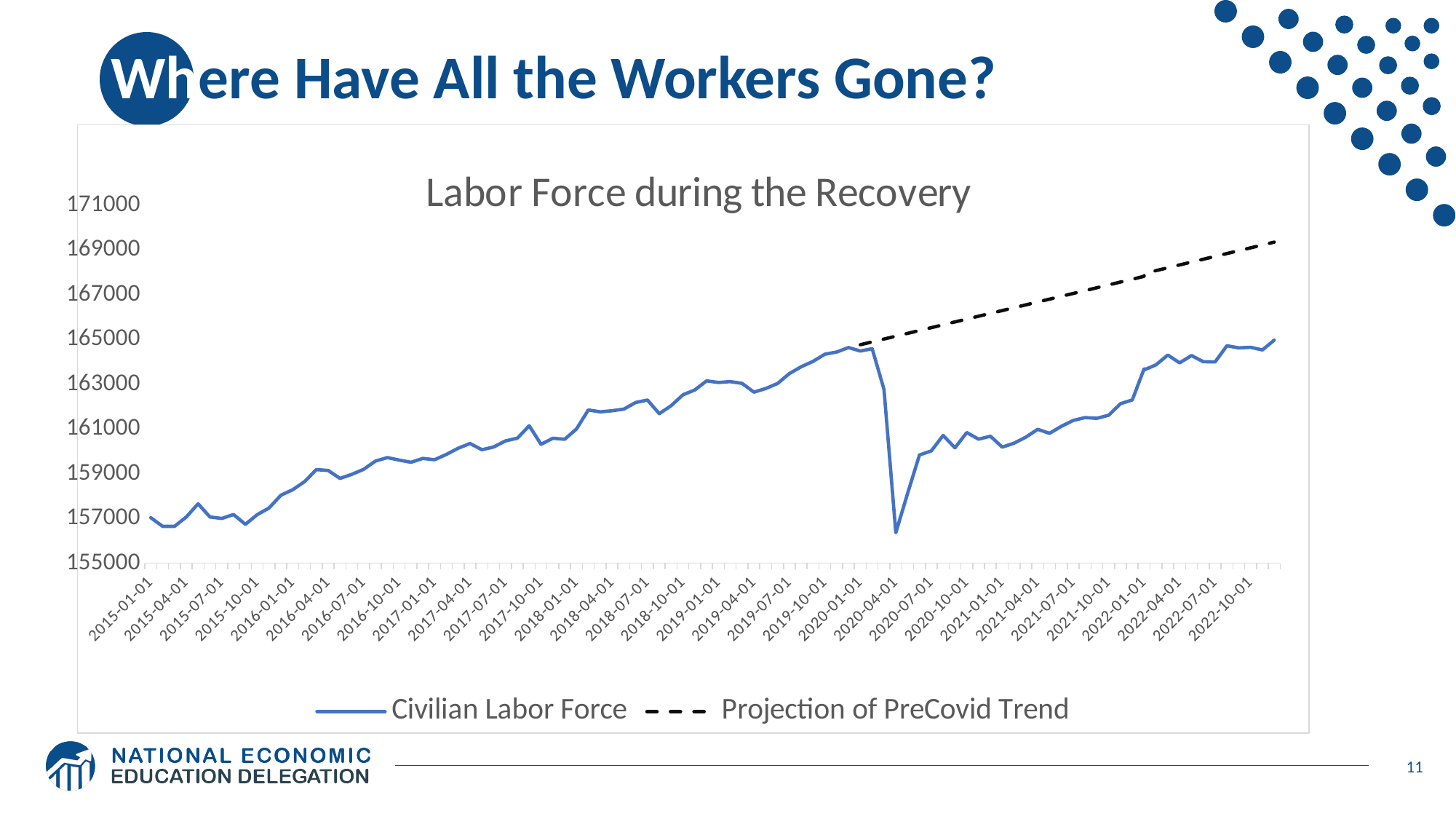
Is the Projection of PreCovid Trend value at 2022-10-01 greater or less than 167000? greater At 2022-10-01, which is higher: the Civilian Labor Force or the Projection of PreCovid Trend? Projection of PreCovid Trend What kind of chart is shown on the slide? line chart Is the Civilian Labor Force value at 2020-04-01 greater or less than 157000? less Which series is drawn as a dashed line? Projection of PreCovid Trend Is the Civilian Labor Force value at 2016-01-01 greater or less than 159000? less Does the Civilian Labor Force generally rise or fall from 2015-01-01 to 2020-01-01? rise At which date does the Civilian Labor Force reach its lowest value? 2020-04-01 How many series does the legend list? 2 What is the title of the chart? Labor Force during the Recovery